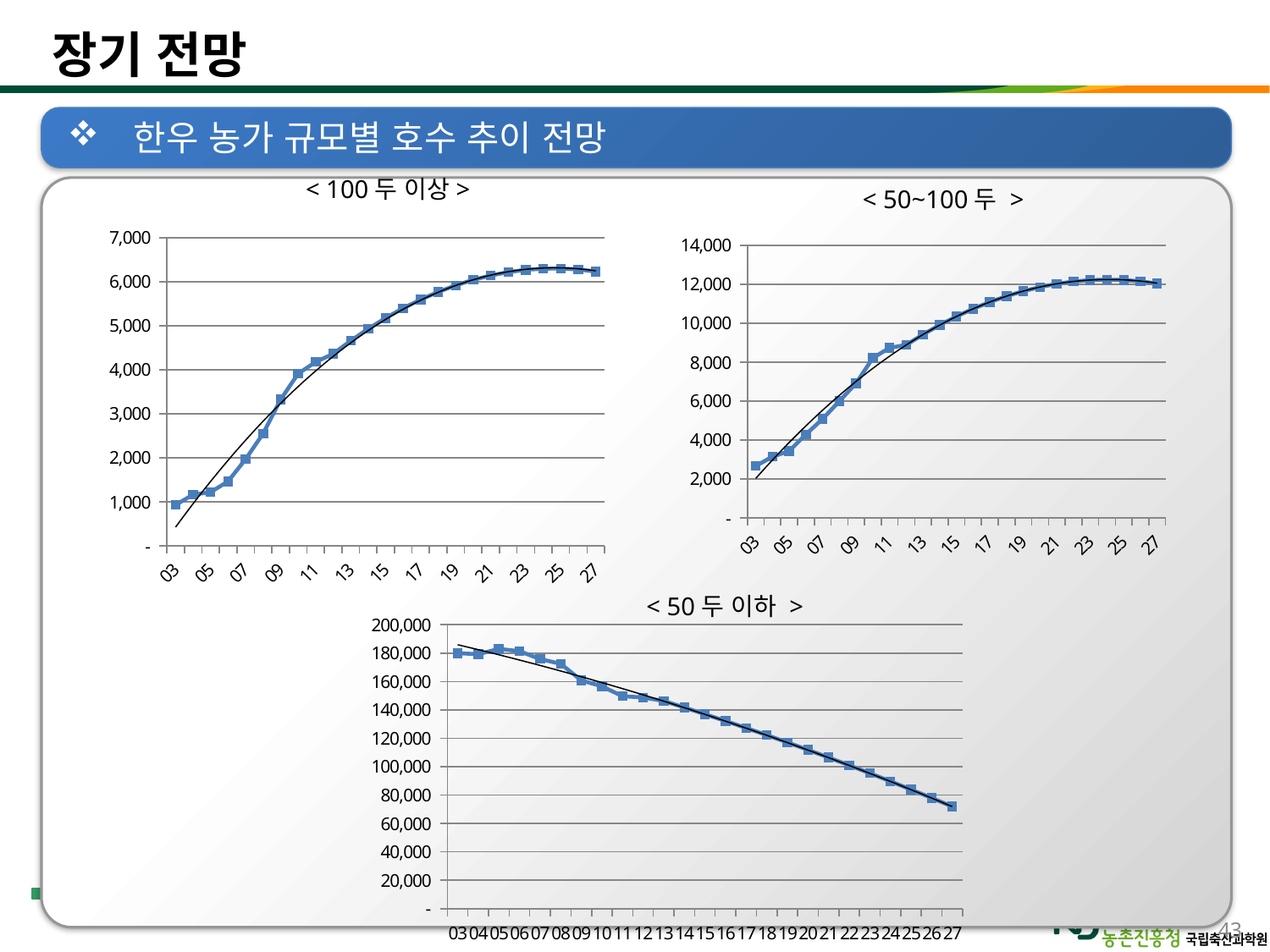
In the '< 50 두 이하 >' chart, do the values rise or fall from 03 to 27? fall In the '< 50 두 이하 >' chart, which year has the lowest value? 27 In the '< 50~100 두 >' chart, is the value for 09 greater or less than 6,000? greater What kind of chart is the '< 100 두 이상 >' chart? line chart In the '< 50~100 두 >' chart, is the value for 13 greater or less than 10,000? less In the '< 100 두 이상 >' chart, is the value for 11 greater or less than 5,000? less In the '< 100 두 이상 >' chart, which year has the lowest value? 03 How many charts are shown on the slide? 3 In the '< 50~100 두 >' chart, do the values generally rise or fall from 03 to 23? rise